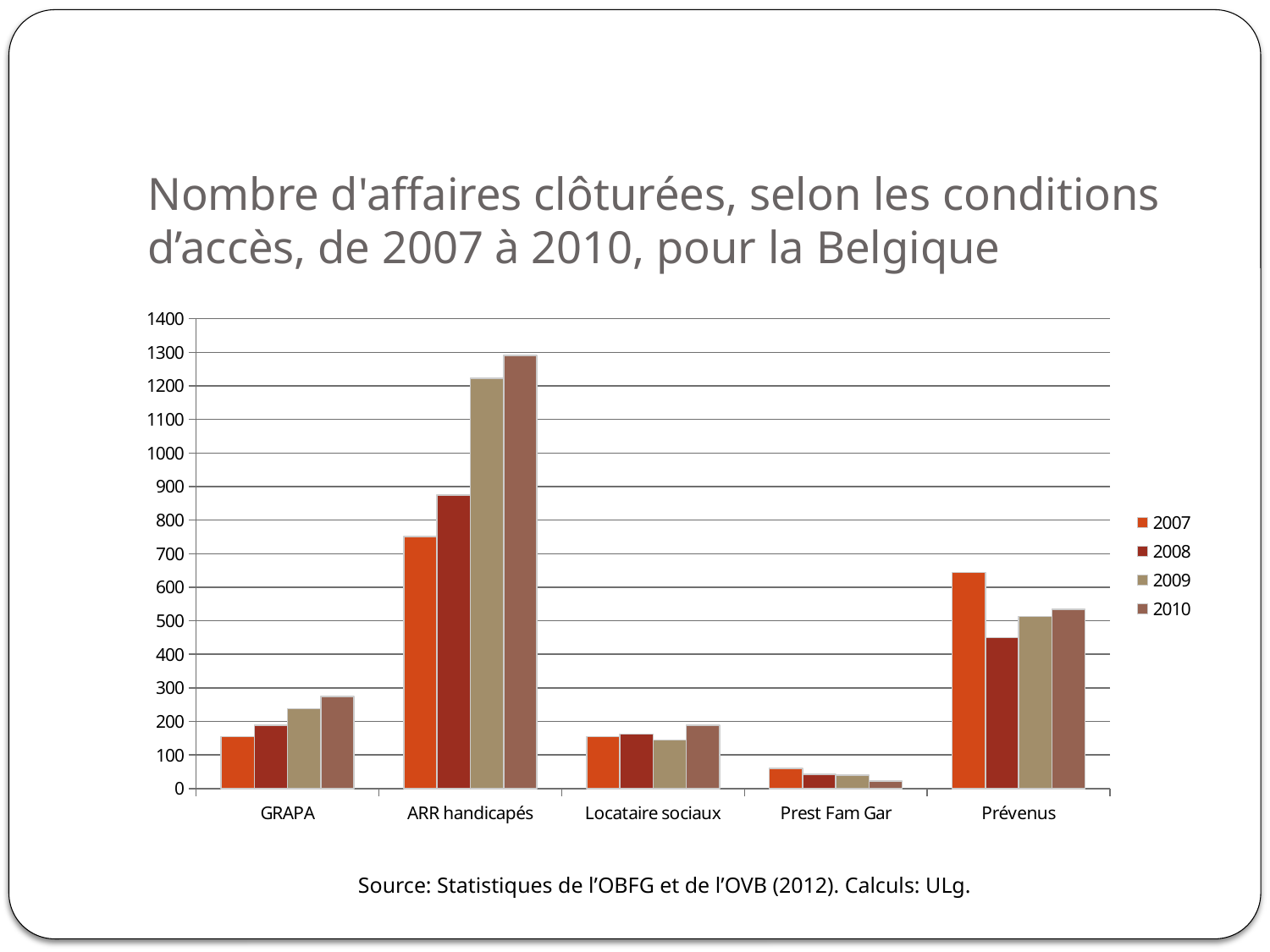
Which category has the highest value for 2010? ARR handicapés Is the value for ARR handicapés in 2010 greater or less than 1200? greater Is the value for Prévenus in 2007 greater or less than 600? greater For Prest Fam Gar, do the values rise or fall from 2007 to 2010? fall How many series does the legend list? 4 How many categories are shown on the x axis? 5 Which category has the lowest value for 2010? Prest Fam Gar What kind of chart is shown on the slide? bar chart Which is larger in 2010, the value for GRAPA or the value for Locataire sociaux? GRAPA For GRAPA, do the values rise or fall from 2007 to 2010? rise What is the title of the chart? Nombre d'affaires clôturées, selon les conditions d'accès, de 2007 à 2010, pour la Belgique For Prévenus, which year has the larger value, 2007 or 2008? 2007